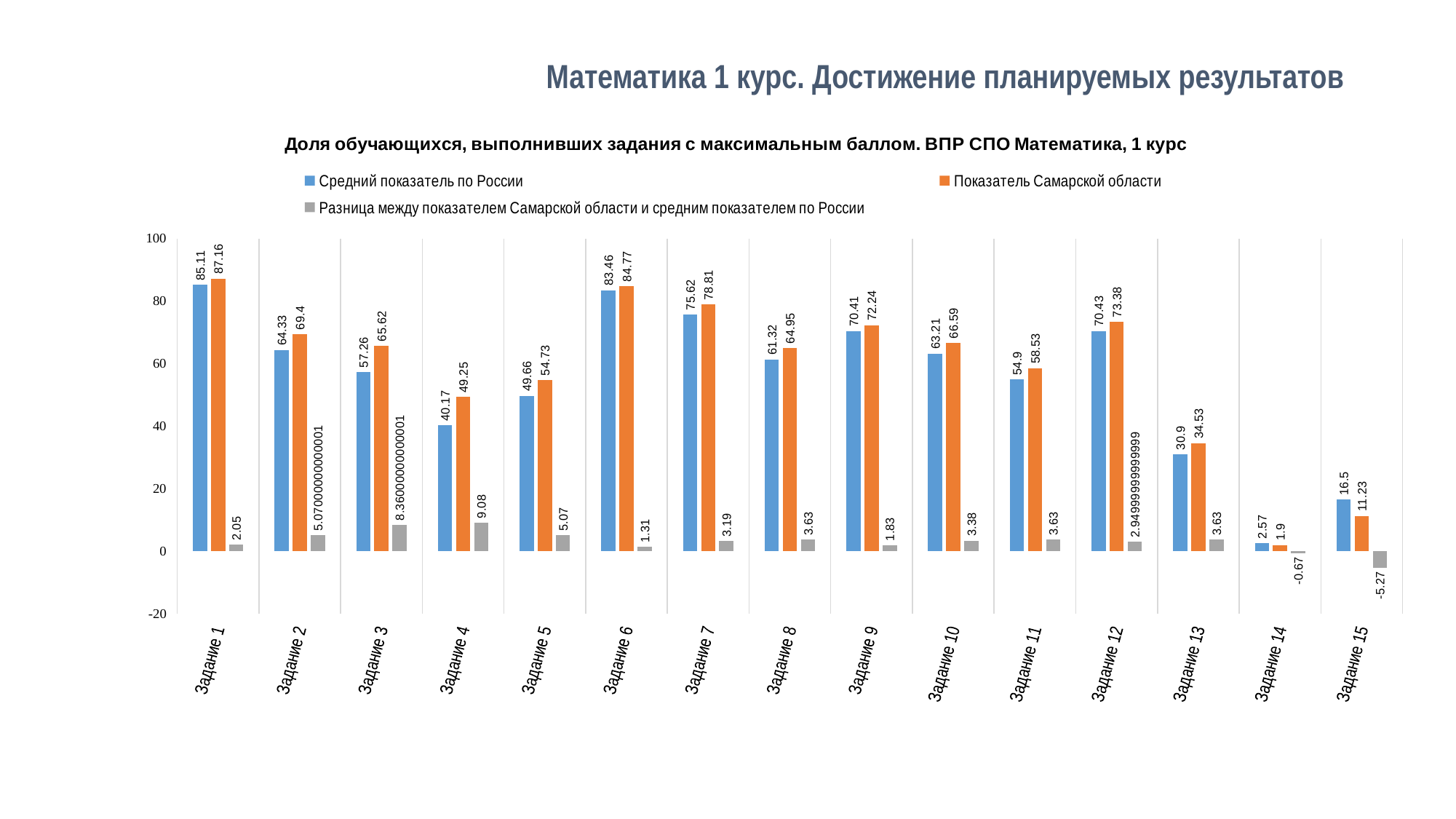
What colour represents «Показатель Самарской области» in the chart? Orange What is the value of «Средний показатель по России» for Задание 1? 85.11 Which task has the lowest value for «Средний показатель по России»? Задание 14 For Задание 15, which is larger: «Средний показатель по России» or «Показатель Самарской области»? Средний показатель по России How many series does the legend list? 3 What is the value of «Разница между показателем Самарской области и средним показателем по России» for Задание 15? -5.27 How many tasks (categories) are shown on the x axis? 15 What kind of chart is shown on the slide? Bar chart Is the value of «Средний показатель по России» for Задание 13 greater or less than 20? greater What is the value of «Показатель Самарской области» for Задание 4? 49.25 Which task has the highest value for «Показатель Самарской области»? Задание 1 What is the difference between «Показатель Самарской области» and «Средний показатель по России» for Задание 4? 9.08